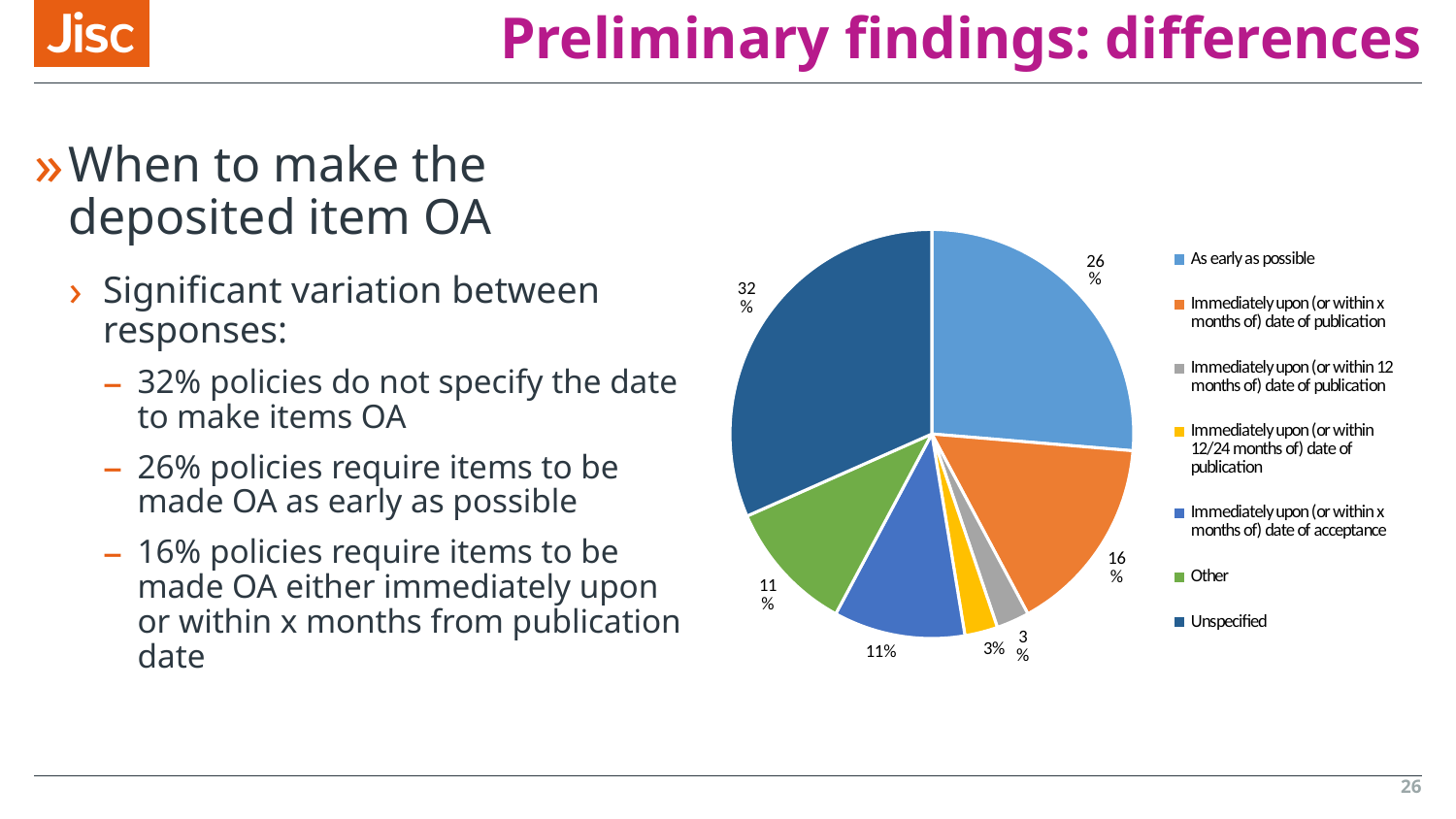
What share of the pie is labelled "Immediately upon (or within x months of) date of acceptance"? 11% Which is larger: the "As early as possible" slice or the "Immediately upon (or within x months of) date of publication" slice? As early as possible What share of the pie is labelled "Other"? 11% What share of the pie is labelled "Unspecified"? 32% How many entries does the legend of the pie chart list? 7 What kind of chart is shown on the slide? pie chart What colour is the "Unspecified" slice in the pie chart? dark blue What is the difference between the "As early as possible" slice and the "Other" slice? 15% What share of the pie is labelled "As early as possible"? 26% Which category has the largest slice of the pie? Unspecified What is the difference between the "Unspecified" slice and the "As early as possible" slice? 6% What share of the pie is labelled "Immediately upon (or within x months of) date of publication"? 16%